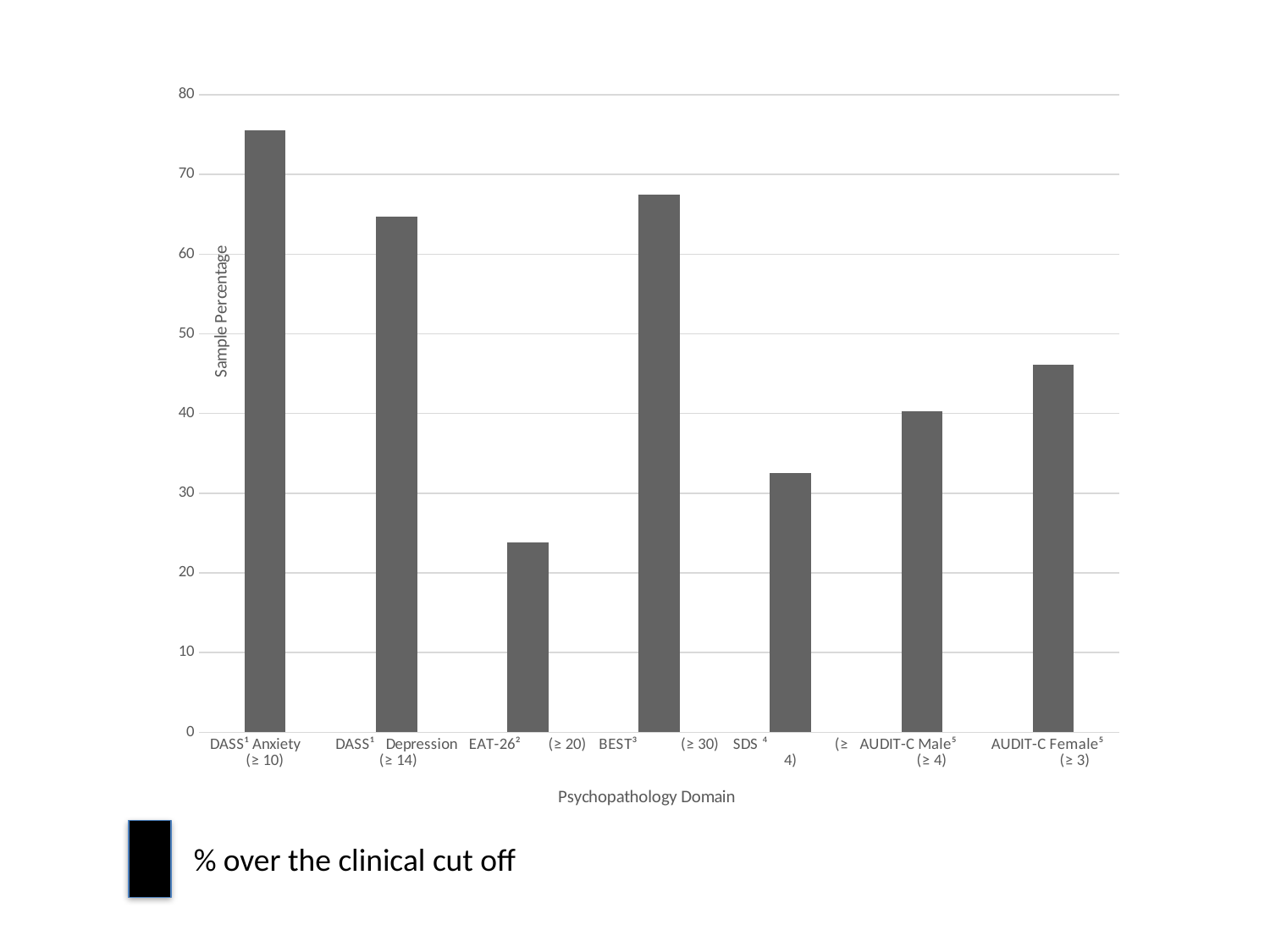
Is the sample percentage for AUDIT-C Female greater or less than 50? less What is the title of the vertical axis of the chart? Sample Percentage Which has a higher sample percentage, SDS or AUDIT-C Male? AUDIT-C Male What kind of chart is shown on the slide? bar chart How many psychopathology domains (bars) are plotted in the chart? 7 Is the sample percentage for BEST greater or less than 70? less Which psychopathology domain has the highest sample percentage over the clinical cut off? DASS Anxiety (≥ 10) Is the sample percentage for SDS greater or less than 30? greater Which psychopathology domain has the lowest sample percentage over the clinical cut off? EAT-26 (≥ 20) Which has a higher sample percentage, AUDIT-C Male or AUDIT-C Female? AUDIT-C Female